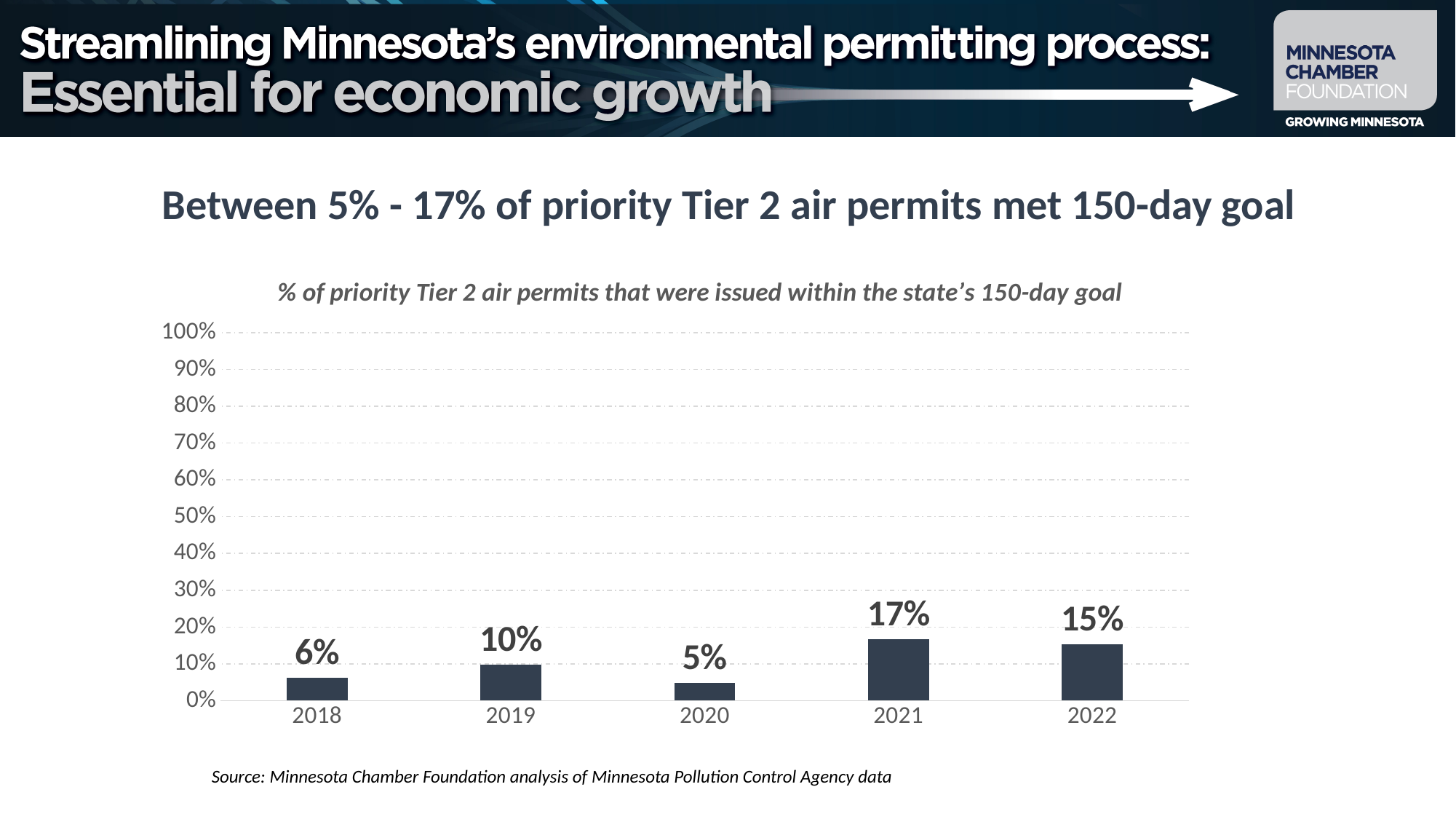
What percentage of priority Tier 2 air permits were issued within the 150-day goal in 2021? 17% How many years are shown on the x axis of the chart? 5 What is the difference between the 2019 value and the 2018 value? 4% What value is shown for 2020? 5% What value is shown for 2018? 6% Which year has a larger value, 2019 or 2022? 2022 Which year has the lowest percentage of permits meeting the 150-day goal? 2020 Which year has the highest percentage of permits meeting the 150-day goal? 2021 Is the value for 2022 greater or less than 20%? less What is the difference between the 2021 value and the 2020 value? 12% What is the title of the chart? % of priority Tier 2 air permits that were issued within the state's 150-day goal What kind of chart is shown on the slide? Bar chart